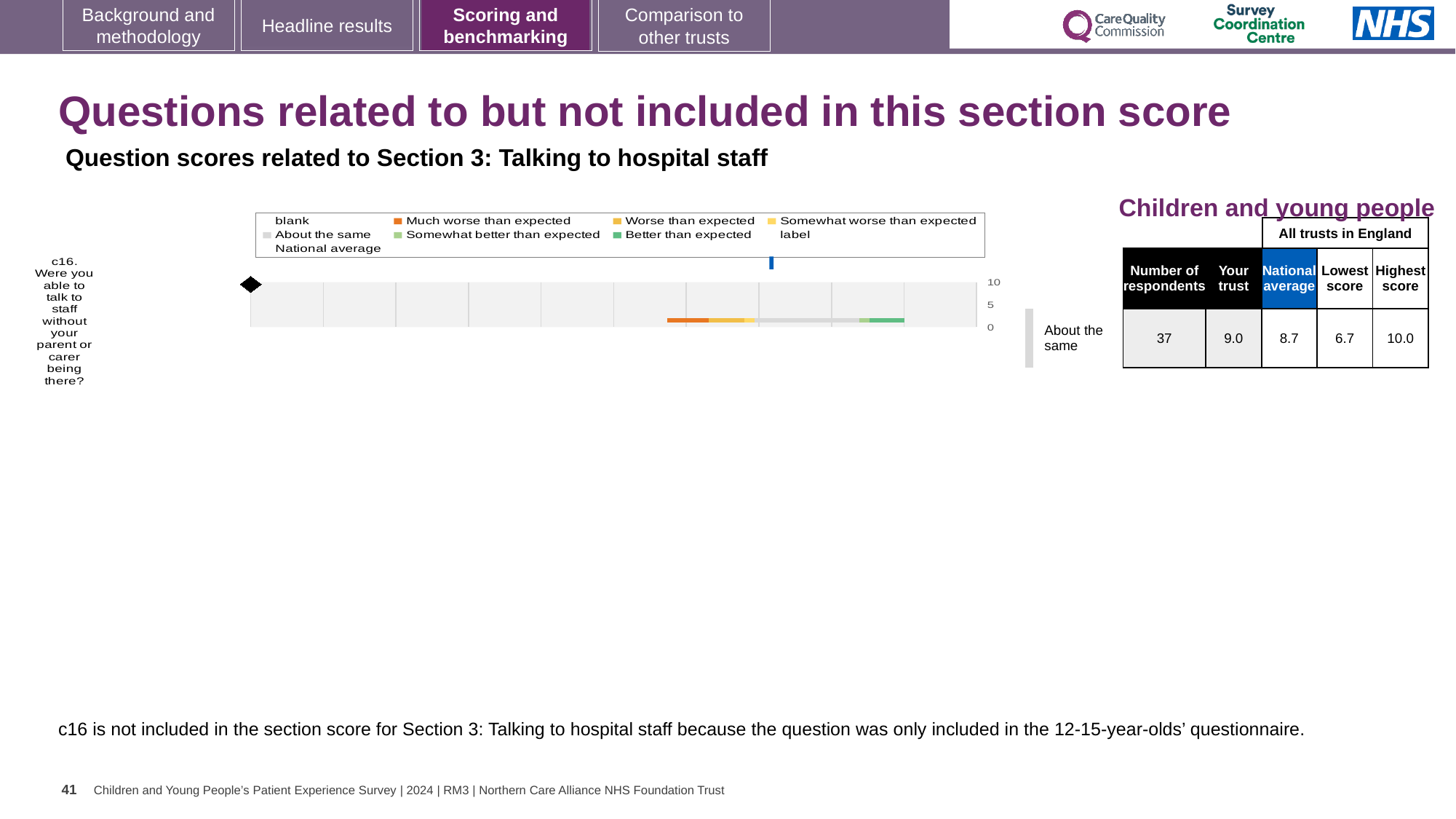
How many survey questions are plotted in the chart? 1 In the table next to the chart, how many respondents answered c16? 37 Which is higher for c16: the 'Your trust' score or the National average? Your trust What is the highest tick value shown on the chart's score axis? 10 What colour represents 'Much worse than expected' in the chart legend? orange How many entries does the chart legend list? 9 Which question code is plotted in the chart? c16 In the table next to the chart, what is the National average score for c16? 8.7 What kind of chart is used to show the c16 benchmarking result? bar chart What is the difference between the Highest score and the Lowest score for c16 in the table? 3.3 In the table next to the chart, what is the Lowest score across all trusts in England for c16? 6.7 In the table next to the chart, what is the 'Your trust' score for c16? 9.0